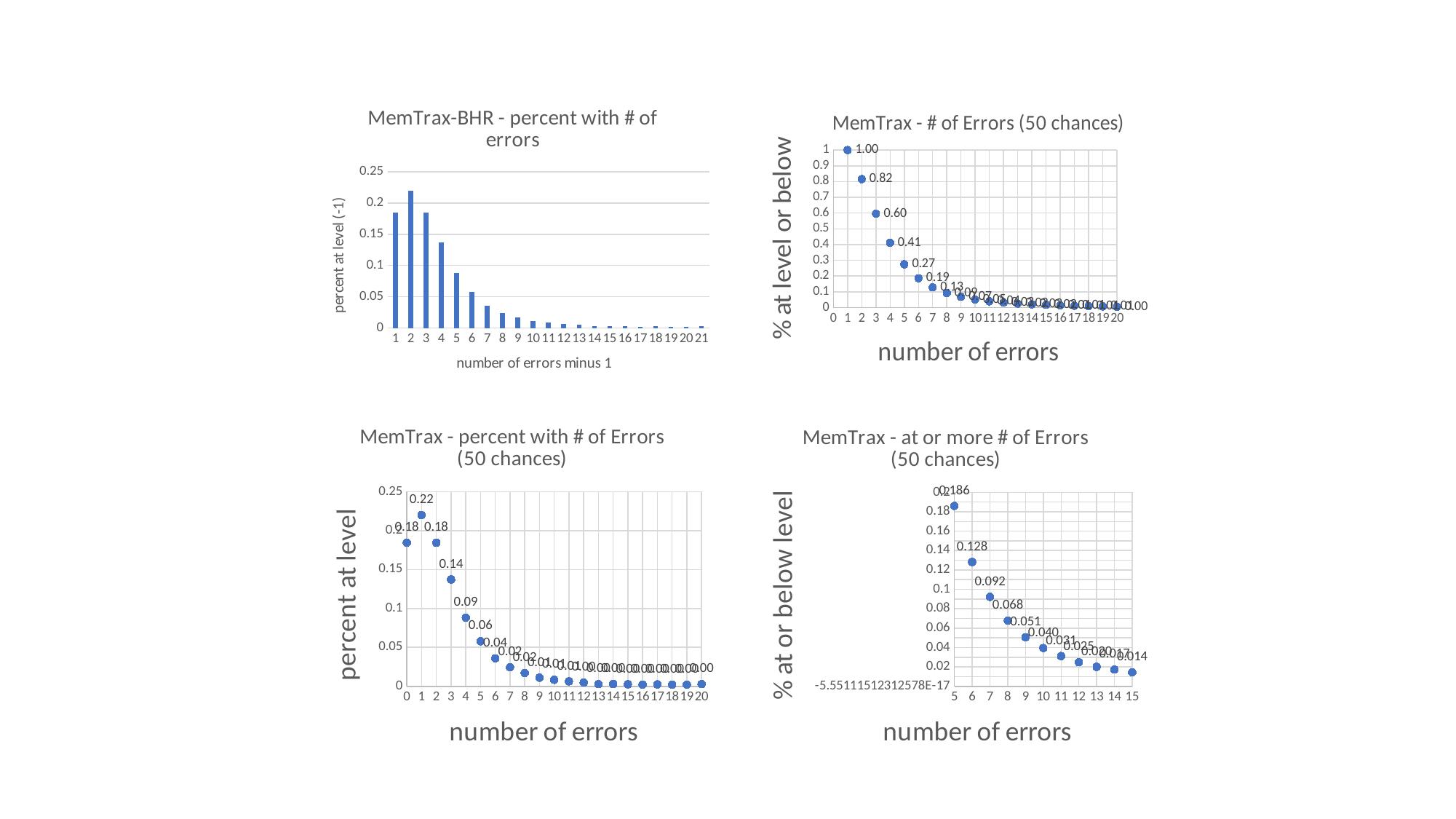
In the top-left chart titled 'MemTrax-BHR - percent with # of errors', which category has the tallest bar? 2 In the chart titled 'MemTrax - at or more # of Errors (50 chances)', what is the value at 15 errors? 0.014 In the chart titled 'MemTrax - at or more # of Errors (50 chances)', what is the value at 5 errors? 0.186 In the chart titled 'MemTrax - percent with # of Errors (50 chances)', what is the value at 4 errors? 0.09 In the chart titled 'MemTrax - at or more # of Errors (50 chances)', do the values rise or fall as the number of errors increases? fall In the chart titled 'MemTrax - # of Errors (50 chances)', what is the difference between the values at 2 errors and 4 errors? 0.41 In the top-left chart titled 'MemTrax-BHR - percent with # of errors', is the value for category 5 greater or less than 0.1? less What kind of chart is the top-left chart titled 'MemTrax-BHR - percent with # of errors'? bar chart In the chart titled 'MemTrax - # of Errors (50 chances)', what is the value at 1 error? 1.00 In the chart titled 'MemTrax - at or more # of Errors (50 chances)', what is the value at 9 errors? 0.051 In the chart titled 'MemTrax - # of Errors (50 chances)', what is the value at 3 errors? 0.60 In the chart titled 'MemTrax - percent with # of Errors (50 chances)', which number of errors has the highest value? 1